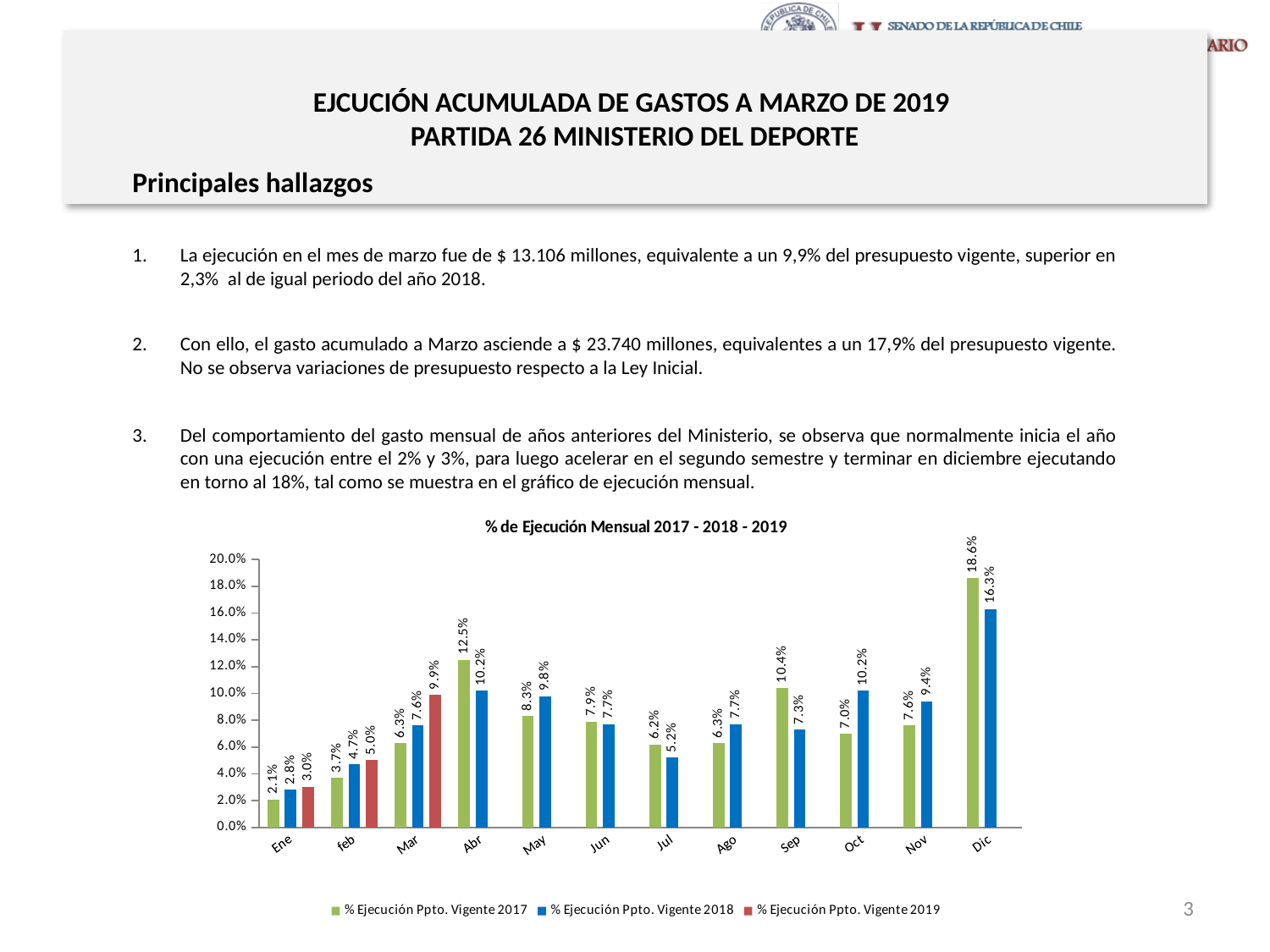
What is the title of the chart? % de Ejecución Mensual 2017 - 2018 - 2019 How many months are shown on the x axis of the chart? 12 Which month has the lowest value in the % Ejecución Ppto. Vigente 2017 series? Ene What is the value for Mar in the % Ejecución Ppto. Vigente 2019 series? 9.9% For Sep, which series has the larger value: % Ejecución Ppto. Vigente 2017 or % Ejecución Ppto. Vigente 2018? % Ejecución Ppto. Vigente 2017 Is the value for Abr in the % Ejecución Ppto. Vigente 2017 series greater or less than 12.0%? greater How many series does the chart legend list? 3 What is the value for Abr in the % Ejecución Ppto. Vigente 2018 series? 10.2% What kind of chart is shown on the slide? Bar chart Which month has the highest value in the % Ejecución Ppto. Vigente 2018 series? Dic What is the difference between the 2017 and 2018 values for Dic? 2.3% What is the value for Dic in the % Ejecución Ppto. Vigente 2017 series? 18.6%